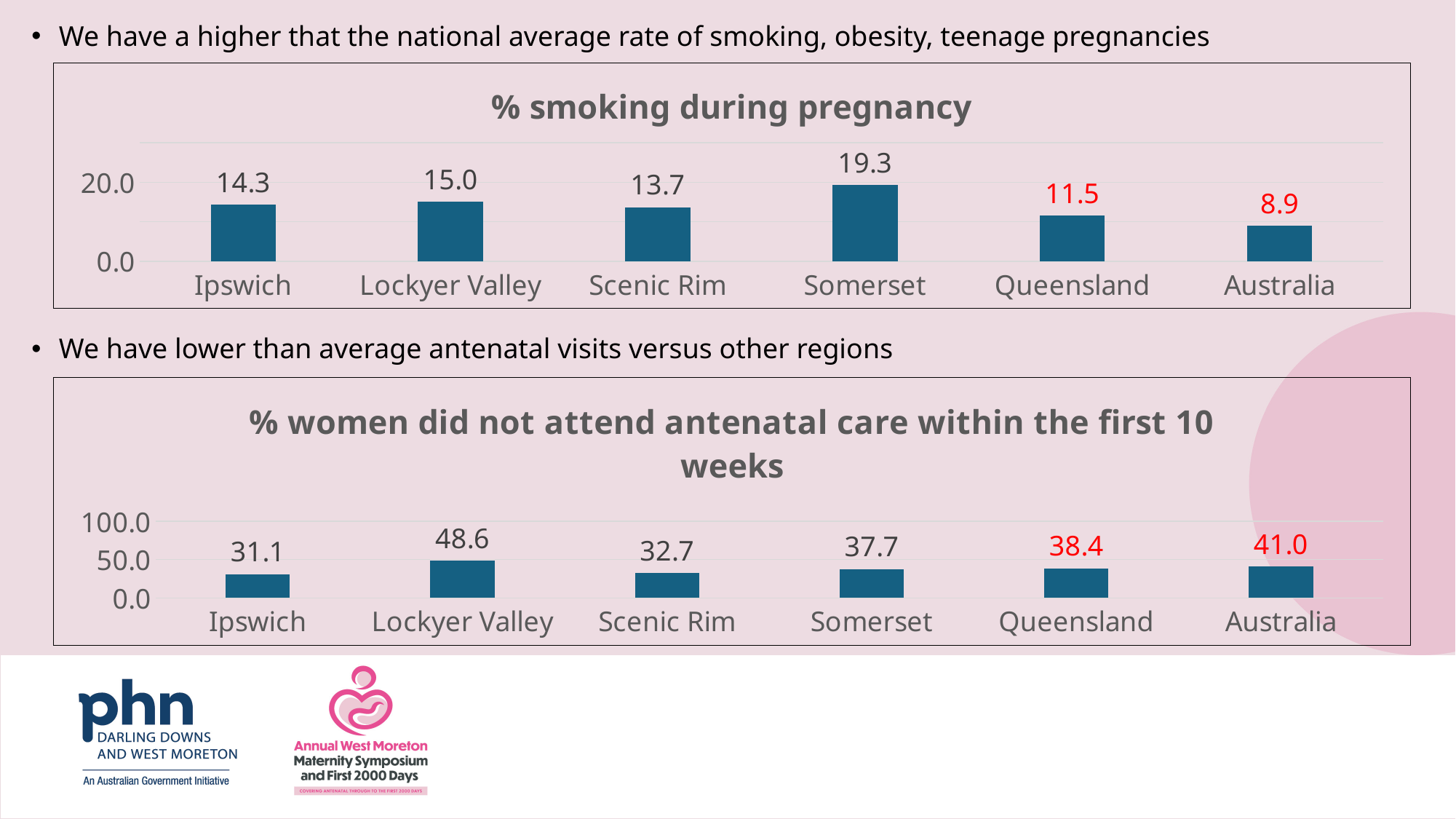
In the '% smoking during pregnancy' chart, which two categories have their data labels shown in red? Queensland and Australia In the '% women did not attend antenatal care within the first 10 weeks' chart, what is the value for Lockyer Valley? 48.6 In the '% women did not attend antenatal care within the first 10 weeks' chart, is the value for Lockyer Valley greater or less than 50.0? less In the '% smoking during pregnancy' chart, which is larger, Ipswich or Scenic Rim? Ipswich In the '% smoking during pregnancy' chart, which category has the highest value? Somerset In the '% smoking during pregnancy' chart, which category has the lowest value? Australia In the '% smoking during pregnancy' chart, what is the value for Somerset? 19.3 How many categories are shown in the '% smoking during pregnancy' chart? 6 What kind of chart is the '% women did not attend antenatal care within the first 10 weeks' chart? bar chart In the '% smoking during pregnancy' chart, what is the difference between Somerset and Australia? 10.4 In the '% women did not attend antenatal care within the first 10 weeks' chart, which category has the lowest value? Ipswich In the '% women did not attend antenatal care within the first 10 weeks' chart, what is the difference between Australia and Queensland? 2.6